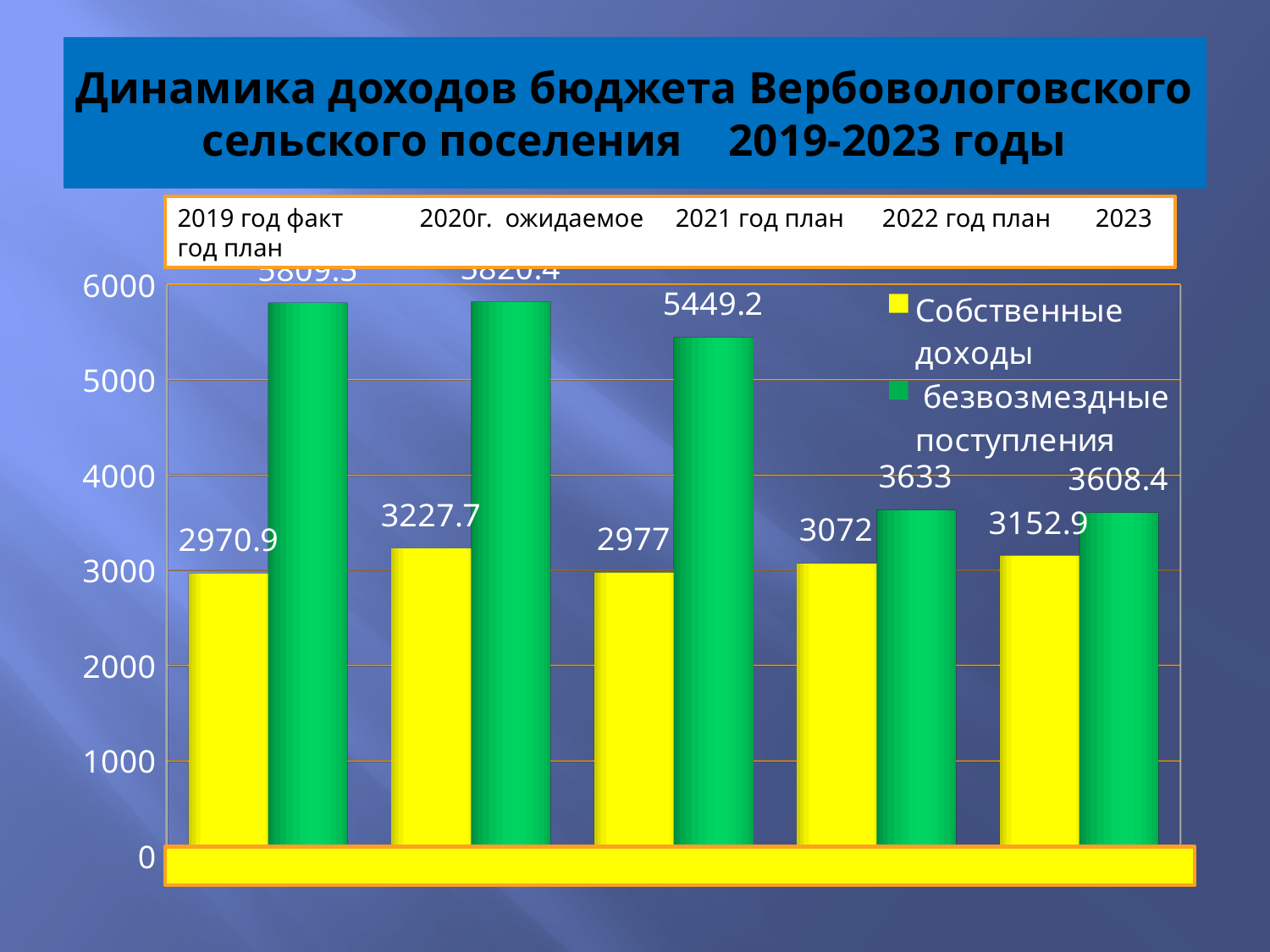
Does безвозмездные поступления rise or fall from 2021 год план to 2023 год план? fall What is the difference between безвозмездные поступления and Собственные доходы for 2022 год план? 561 What is the value of Собственные доходы for 2022 год план? 3072 In which year is безвозмездные поступления lowest? 2023 год план What is the value of безвозмездные поступления for 2023 год план? 3608.4 Is the value of безвозмездные поступления for 2019 год факт greater or less than 5000? greater How many series does the legend list? 2 Which is larger for 2021 год план: Собственные доходы or безвозмездные поступления? безвозмездные поступления How many years are shown on the chart? 5 In which year is Собственные доходы highest? 2020г. ожидаемое What is the value of безвозмездные поступления for 2021 год план? 5449.2 What is the value of Собственные доходы for 2020г. ожидаемое? 3227.7